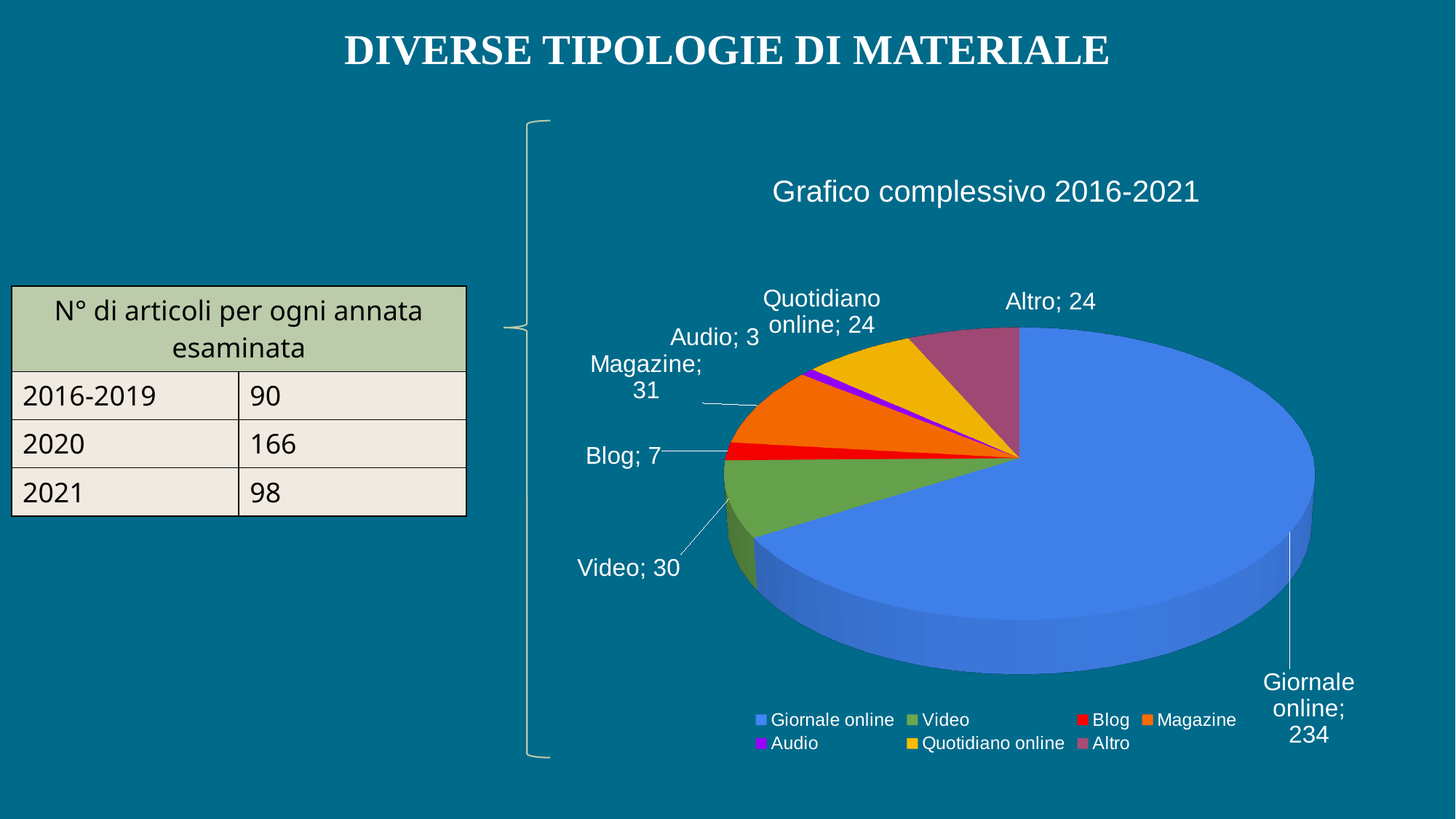
Which category has the smallest slice in the pie chart? Audio What is the value for Giornale online in the pie chart? 234 What is the title of the chart? Grafico complessivo 2016-2021 What kind of chart is shown on the slide? pie chart What is the value for Magazine in the pie chart? 31 What is the difference between the values for Giornale online and Altro? 210 What is the value for Audio in the pie chart? 3 What is the difference between the values for Magazine and Video? 1 Which category has the largest slice in the pie chart? Giornale online Which is larger, the value for Blog or the value for Audio? Blog How many categories are shown in the pie chart? 7 What is the total of all the values shown in the pie chart? 353